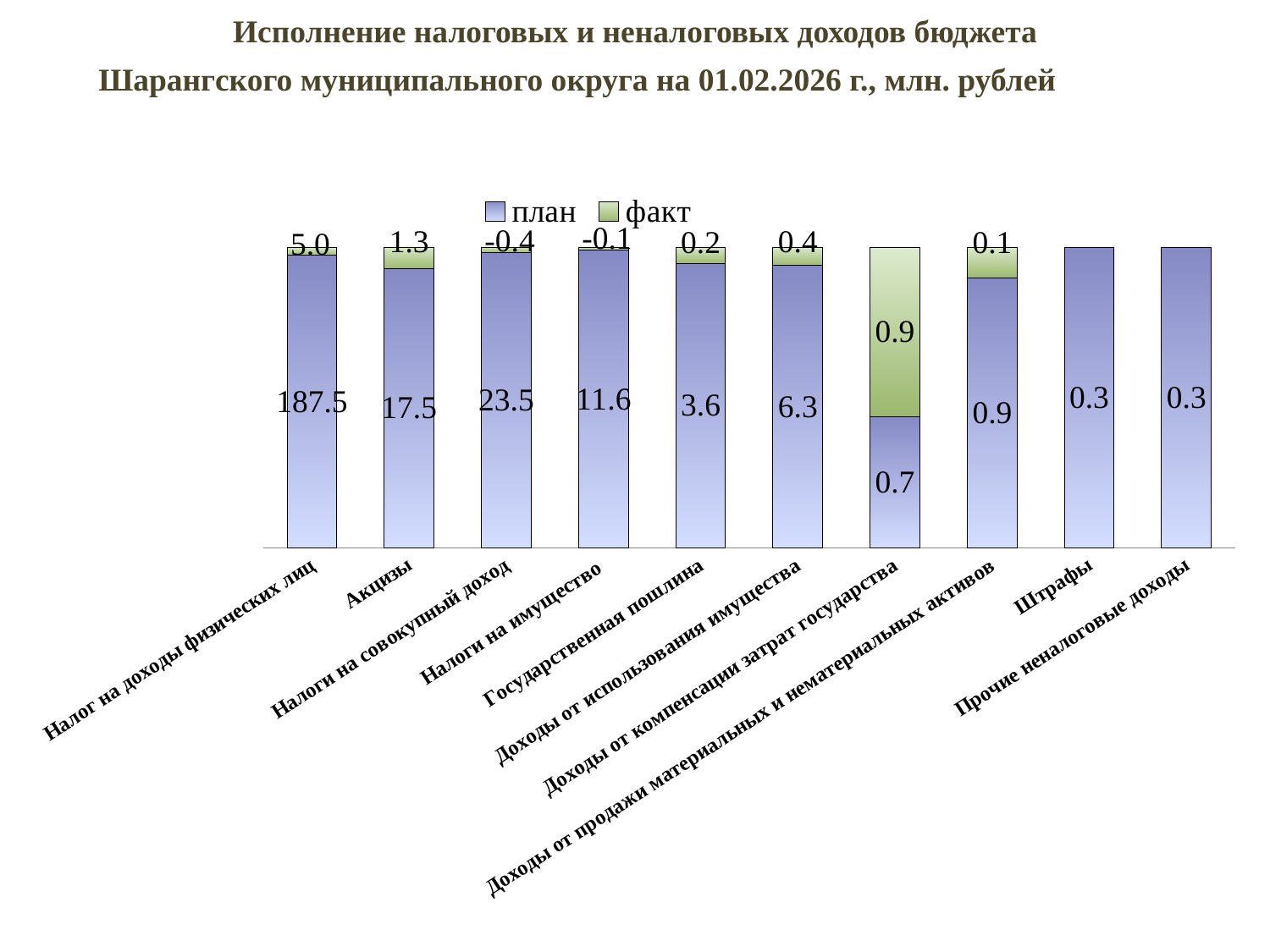
What is the факт value for Доходы от компенсации затрат государства? 0.9 What is the факт value for Акцизы? 1.3 How many categories are shown on the x axis? 10 Which category has the highest план value? Налог на доходы физических лиц How many series does the legend list? 2 What is the план value for Налог на доходы физических лиц? 187.5 What kind of chart is shown on the slide? Stacked bar chart What is the difference between the план values for Акцизы and Налоги на имущество? 5.9 Which is larger, the план value for Государственная пошлина or the план value for Доходы от использования имущества? Доходы от использования имущества Which series is shown in green in the legend? факт What is the факт value for Налоги на имущество? -0.1 What is the план value for Налоги на совокупный доход? 23.5